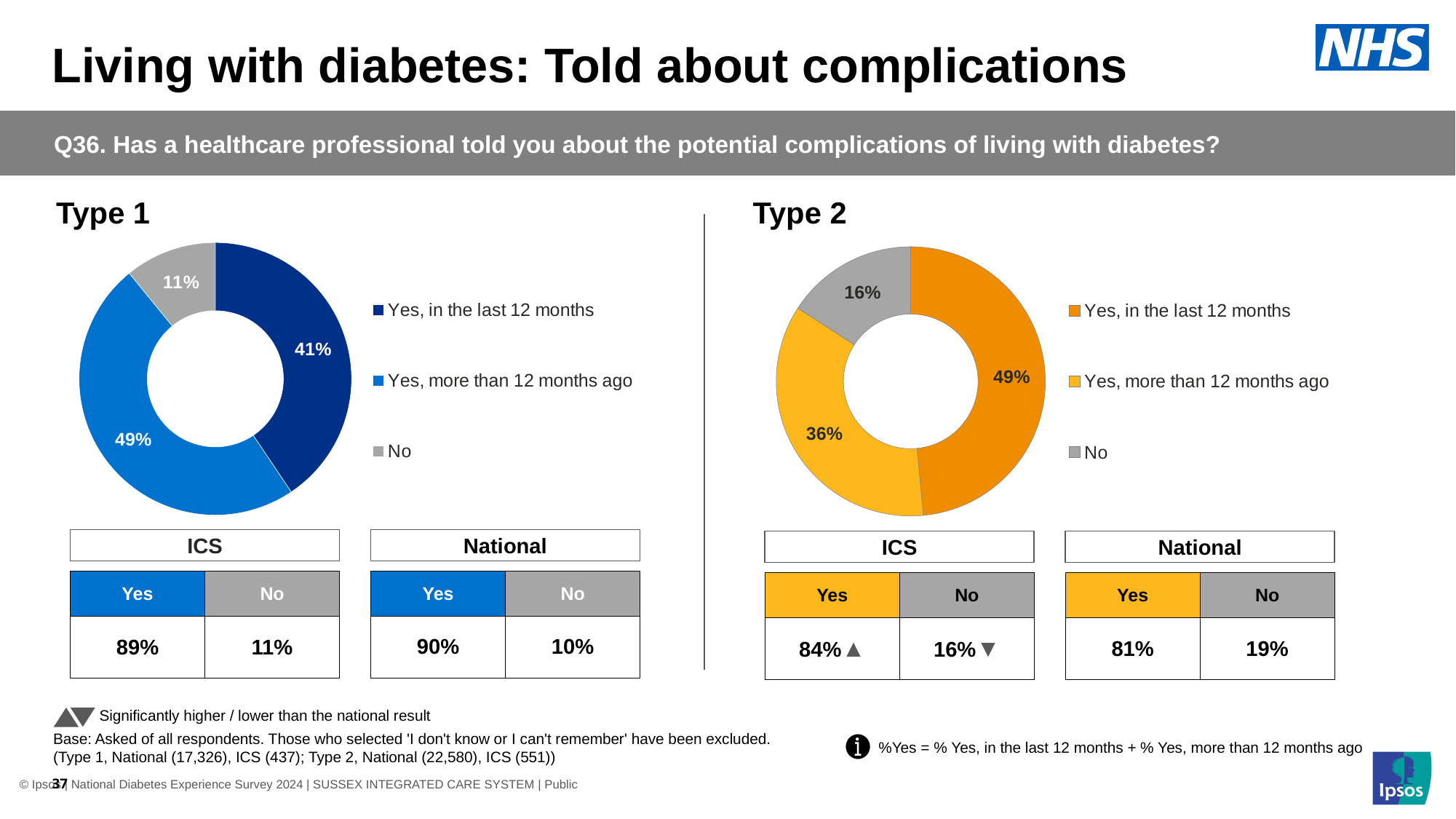
What kind of chart is used for Type 1? Doughnut (pie) chart In the Type 1 chart, what percentage of respondents said 'No'? 11% In the Type 1 chart, what percentage of respondents said 'Yes, in the last 12 months'? 41% In the Type 1 chart, which is larger: 'Yes, in the last 12 months' or 'Yes, more than 12 months ago'? Yes, more than 12 months ago How many entries does the legend of the Type 1 chart list? 3 In the Type 2 chart, what percentage of respondents said 'Yes, more than 12 months ago'? 36% In the Type 2 chart, what is the difference between the 'Yes, in the last 12 months' share and the 'Yes, more than 12 months ago' share? 13 percentage points How many slices does the Type 2 chart have? 3 In the Type 1 chart, which response category has the largest share? Yes, more than 12 months ago In the Type 2 chart, which response category has the smallest share? No In the Type 2 chart, what percentage of respondents said 'No'? 16% In the Type 2 chart, what colour is the 'No' slice? Grey